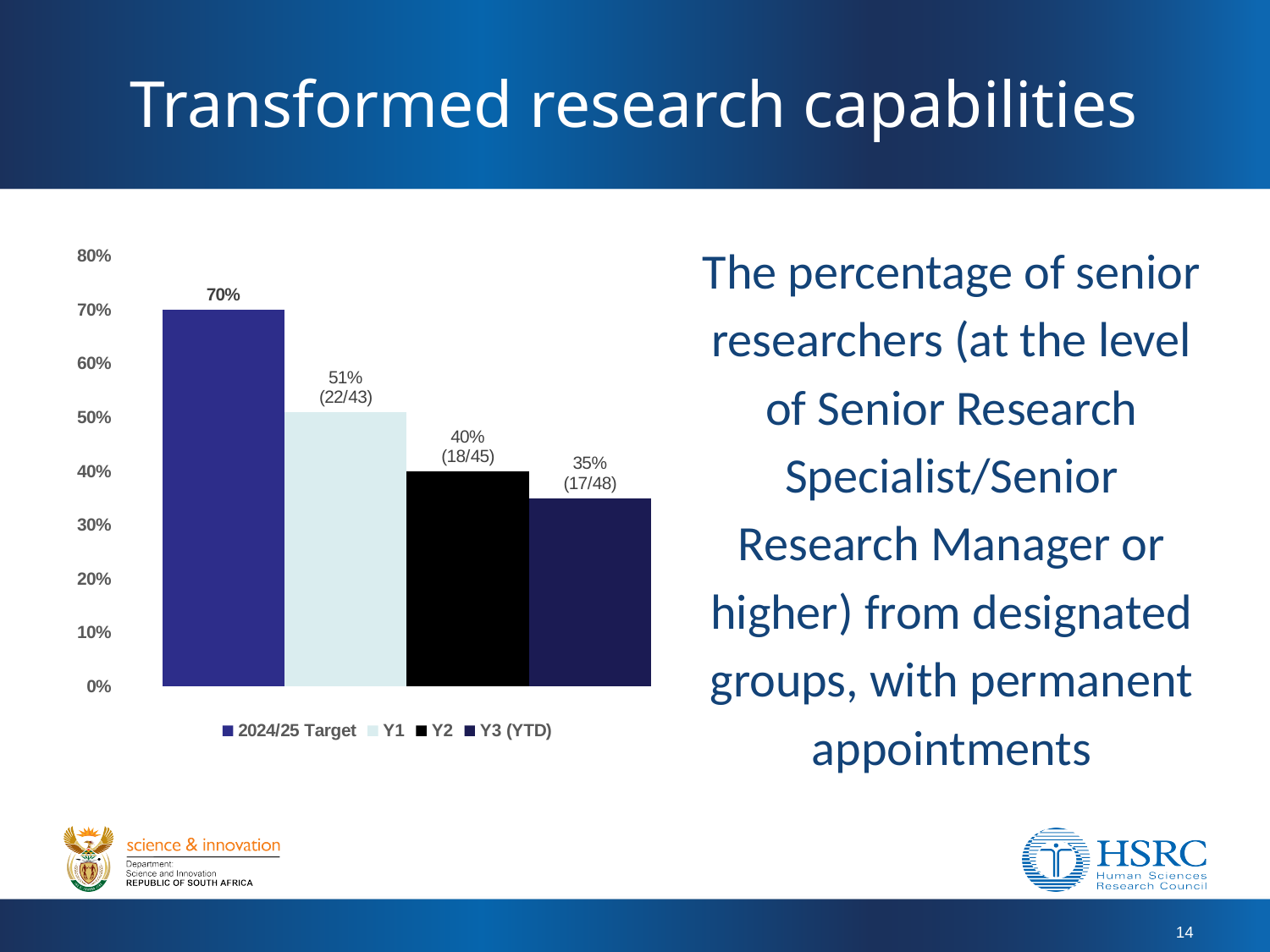
What is the value for Y2? 40% What is the value for Y1? 51% What is the difference between the Y1 and Y2 values? 11% Do the values rise or fall from Y1 to Y3 (YTD)? Fall What is the difference between the 2024/25 Target and the Y3 (YTD) value? 35% Which bar has the lowest value? Y3 (YTD) What is the value for Y3 (YTD)? 35% Which is larger, the value for Y1 or the value for Y2? Y1 What kind of chart is shown on the slide? Bar chart Which bar has the highest value? 2024/25 Target What is the value for the 2024/25 Target bar? 70% How many series does the legend list? 4